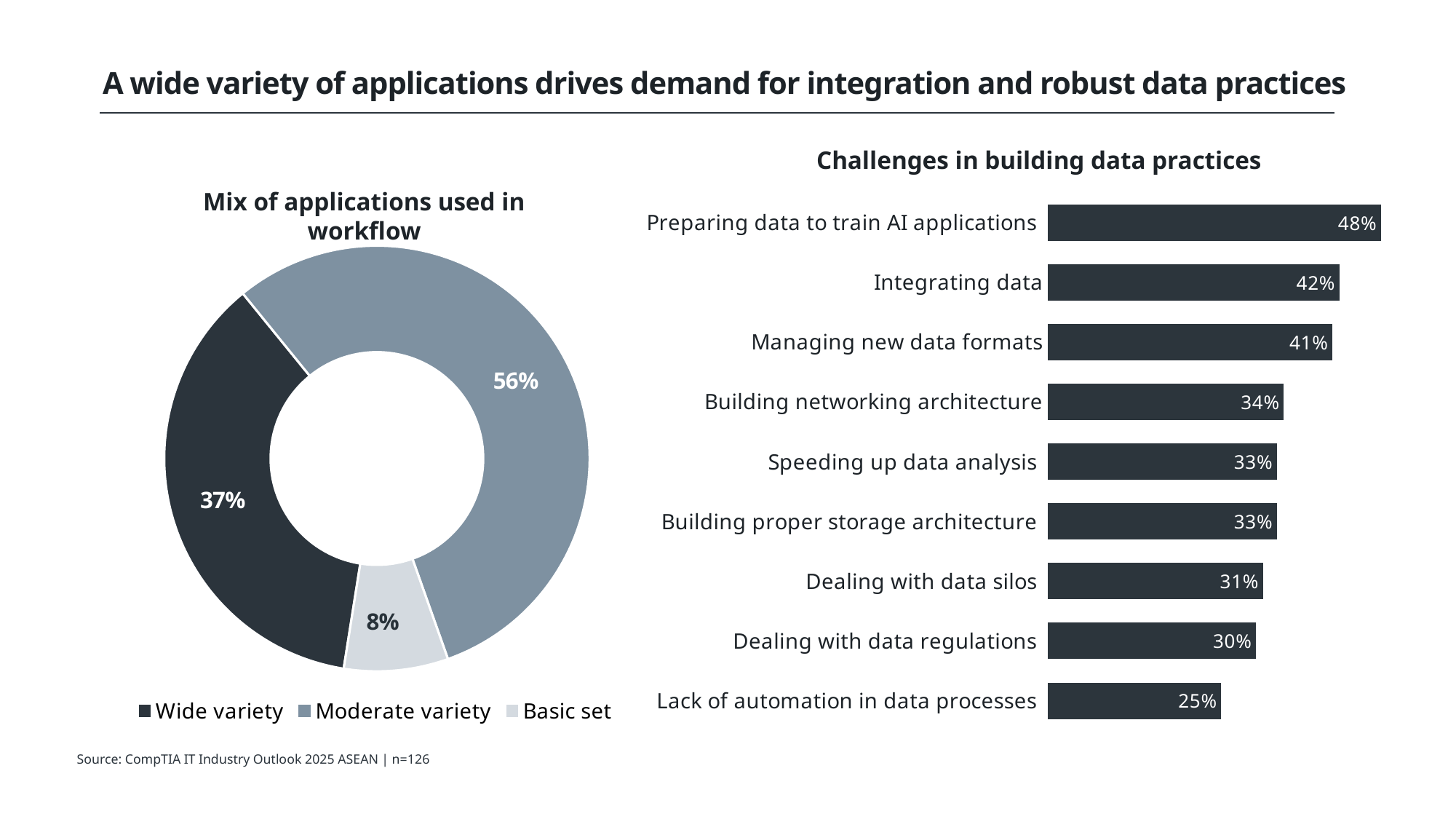
In the 'Mix of applications used in workflow' chart, which category has the largest share? Moderate variety In the 'Challenges in building data practices' chart, how many challenges are listed? 9 What kind of chart is 'Mix of applications used in workflow'? Doughnut (pie) chart In the 'Challenges in building data practices' chart, what is the difference between Managing new data formats and Dealing with data regulations? 11% In the 'Mix of applications used in workflow' chart, how many categories does the legend list? 3 In the 'Mix of applications used in workflow' chart, what is the difference between the Wide variety and Basic set shares? 29% In the 'Challenges in building data practices' chart, what is the value for Integrating data? 42% In the 'Mix of applications used in workflow' chart, what share is labelled for Moderate variety? 56% In the 'Challenges in building data practices' chart, which challenge has the lowest value? Lack of automation in data processes In the 'Mix of applications used in workflow' chart, what share is labelled for Basic set? 8% In the 'Challenges in building data practices' chart, which is larger: Building networking architecture or Dealing with data silos? Building networking architecture In the 'Challenges in building data practices' chart, which challenge has the highest value? Preparing data to train AI applications